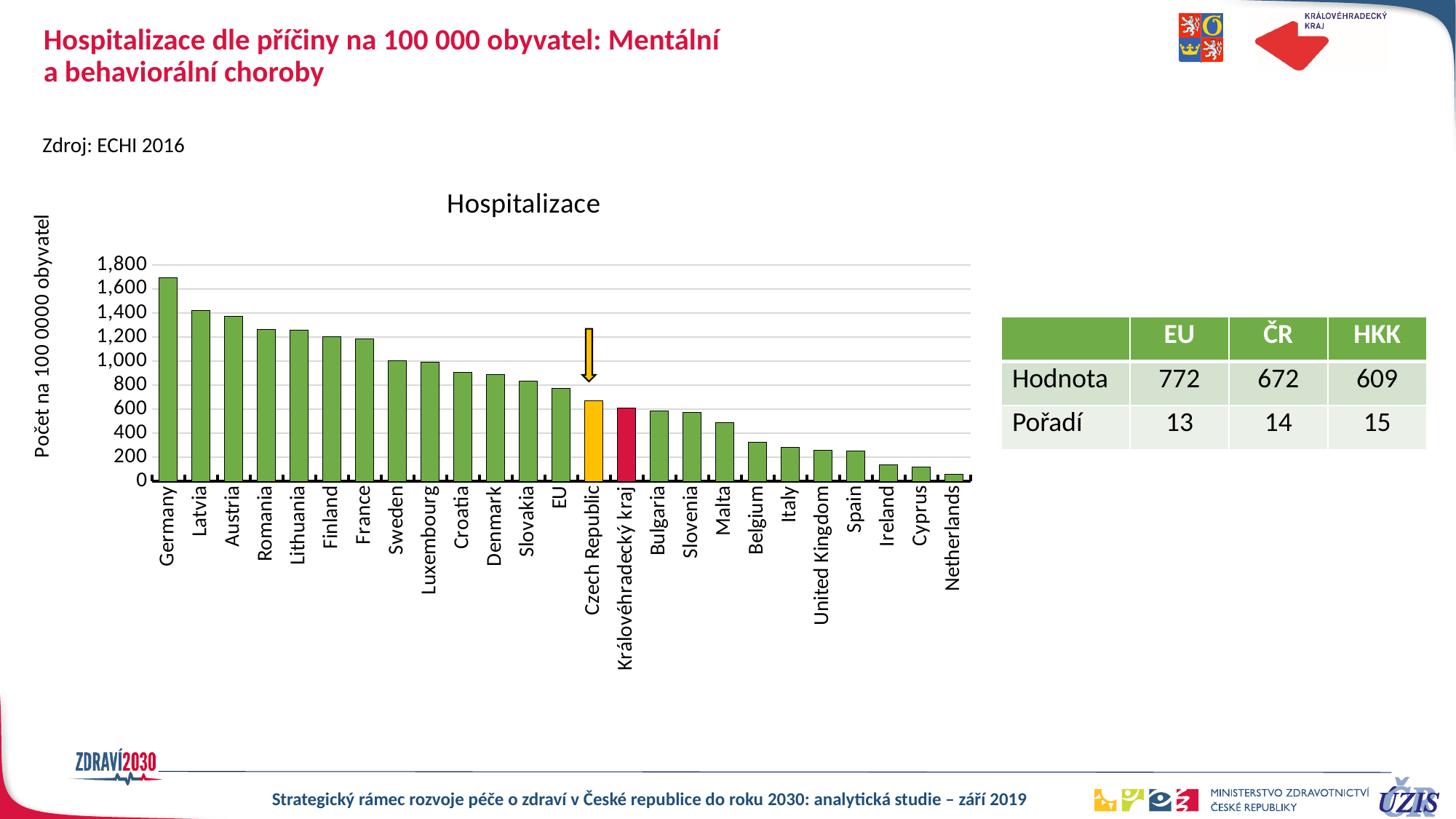
What type of chart is shown on the slide? bar chart Which country has the highest hospitalization rate in the chart? Germany Do the values rise or fall moving from left to right along the x axis? fall Is the value for Malta greater or less than 600? less Is the value for Germany greater or less than 1,600? greater What is the difference between the EU value and the Czech Republic value? 100 Which country has the lowest hospitalization rate in the chart? Netherlands What is the hospitalization value for Královéhradecký kraj (HKK) according to the slide? 609 What is the hospitalization value for the EU according to the slide? 772 What is the title of the chart? Hospitalizace How many bars (categories) are plotted in the chart? 25 What is the hospitalization value for the Czech Republic (ČR) according to the slide? 672